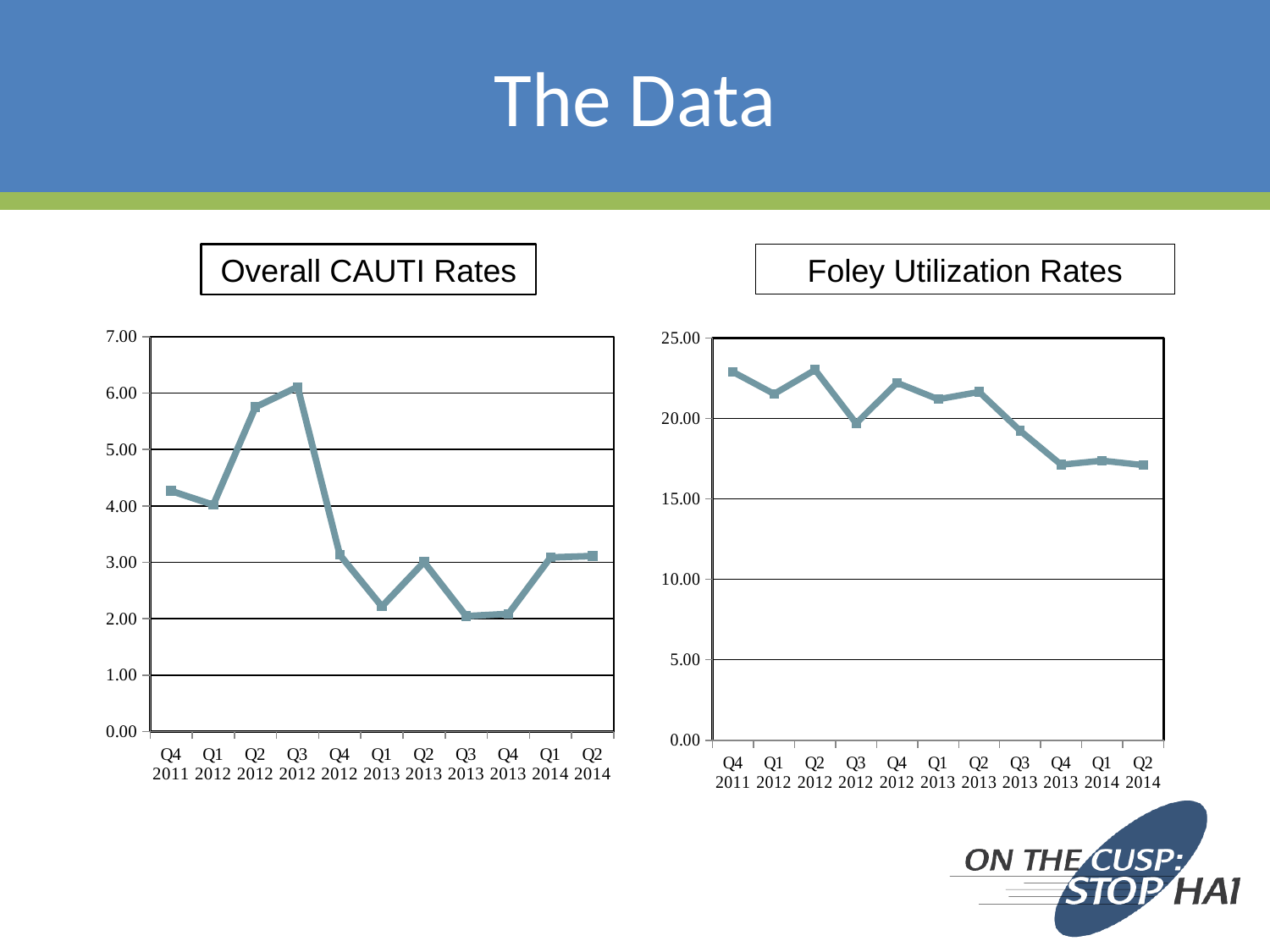
How many quarters are plotted on the Overall CAUTI Rates chart? 11 On the Foley Utilization Rates chart, which is larger, the value for Q4 2011 or the value for Q2 2014? Q4 2011 On the Foley Utilization Rates chart, do the values generally rise or fall from Q4 2011 to Q2 2014? fall On the Overall CAUTI Rates chart, is the value for Q3 2012 greater or less than 6.00? greater On the Overall CAUTI Rates chart, which quarter has the highest rate? Q3 2012 What kind of chart is the Overall CAUTI Rates chart? line chart What kind of chart is the Foley Utilization Rates chart? line chart On the Foley Utilization Rates chart, is the value for Q4 2011 greater or less than 20.00? greater On the Overall CAUTI Rates chart, which is larger, the value for Q2 2012 or the value for Q4 2012? Q2 2012 How many quarters are plotted on the Foley Utilization Rates chart? 11 On the Overall CAUTI Rates chart, is the value for Q1 2013 greater or less than 3.00? less